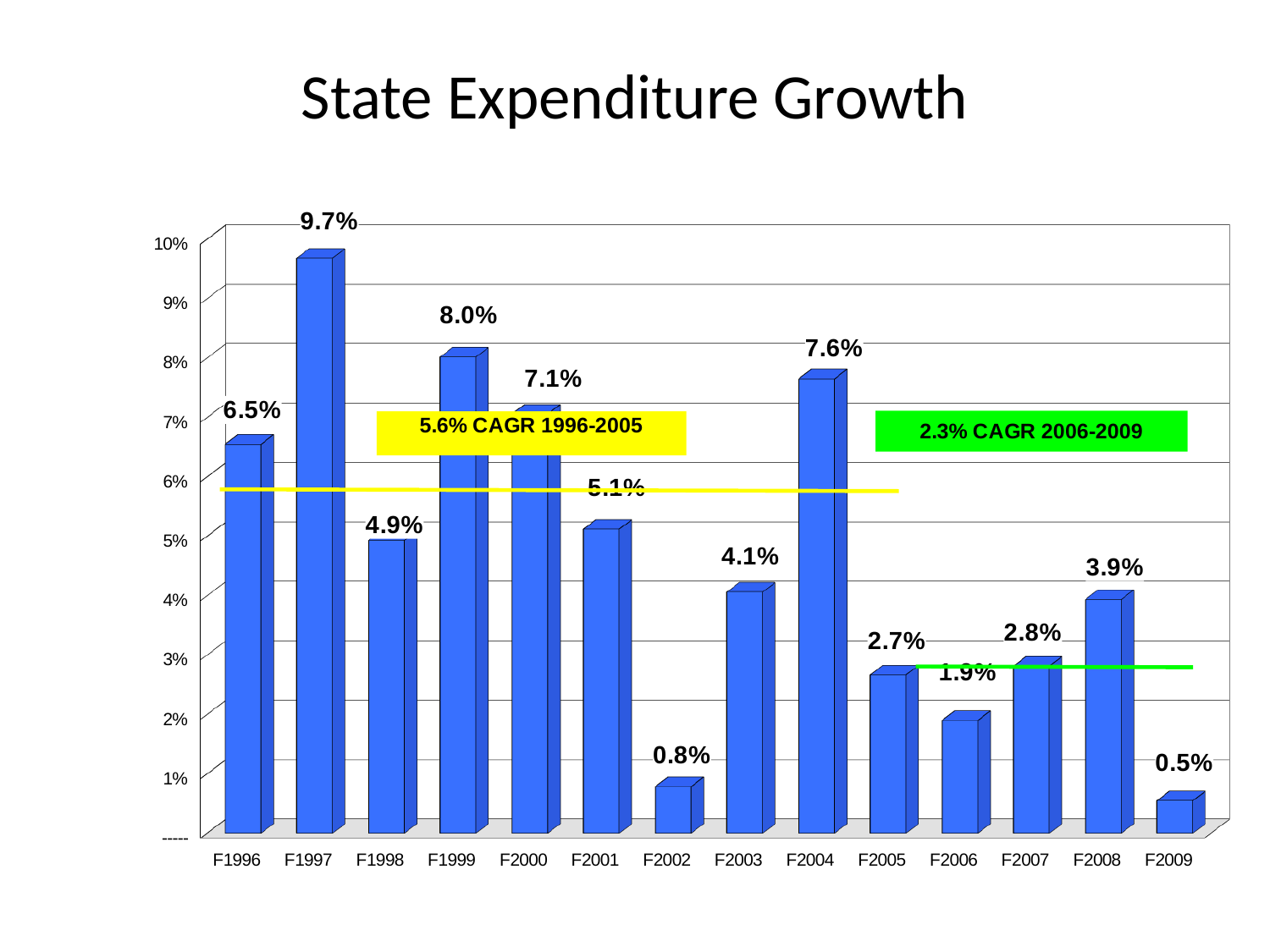
What is the value shown for F2004? 7.6% Is the value for F2002 greater or less than 1%? less What is the difference between the values for F1999 and F1998? 3.1% What is the value shown for F2009? 0.5% What is the state expenditure growth value for F1997? 9.7% What CAGR is shown in the yellow box for 1996-2005? 5.6% How many fiscal years are shown on the x axis? 14 Which is larger, the value for F2003 or the value for F2008? F2003 Which fiscal year has the highest expenditure growth? F1997 What kind of chart is shown on the slide? bar chart Which fiscal year has the lowest expenditure growth? F2009 What CAGR is shown in the green box for 2006-2009? 2.3%